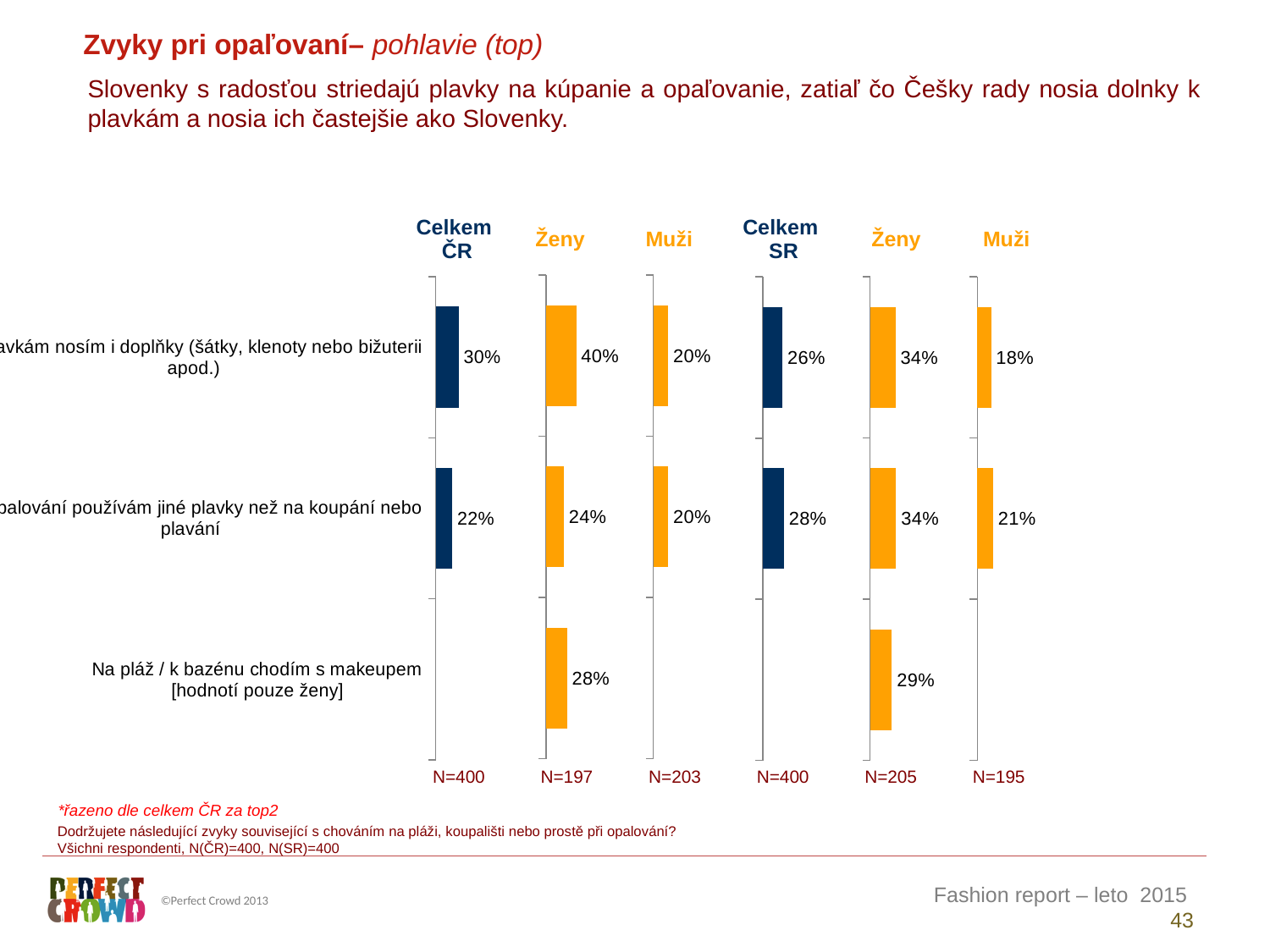
For the second row (jiné plavky), what is the difference between the Ženy SR value and the Muži SR value? 13 percentage points What is the sample size (N) shown under the Muži chart for SR? N=195 In the Celkem SR chart, what is the value for the second row (jiné plavky než na koupání nebo plavání)? 28% For 'Na pláž / k bazénu chodím s makeupem', which is larger: the Ženy ČR value or the Ženy SR value? Ženy SR What kind of chart is used on this slide? Bar chart In the Ženy chart for ČR, what is the value for 'Na pláž / k bazénu chodím s makeupem [hodnotí pouze ženy]'? 28% In the Ženy chart for ČR, which row has the highest value? The top row (doplňky – šátky, klenoty nebo bižuterii apod.), 40% For the top row (doplňky), what is the difference between the Ženy ČR value and the Muži ČR value? 20 percentage points For the top row (doplňky), which is larger: the Celkem ČR value or the Celkem SR value? Celkem ČR In the Celkem ČR chart, what is the value for the top row (doplňky – šátky, klenoty nebo bižuterii apod.)? 30% How many category rows are plotted in the charts? 3 In the Muži chart for SR, what is the value for the top row (doplňky – šátky, klenoty nebo bižuterii apod.)? 18%